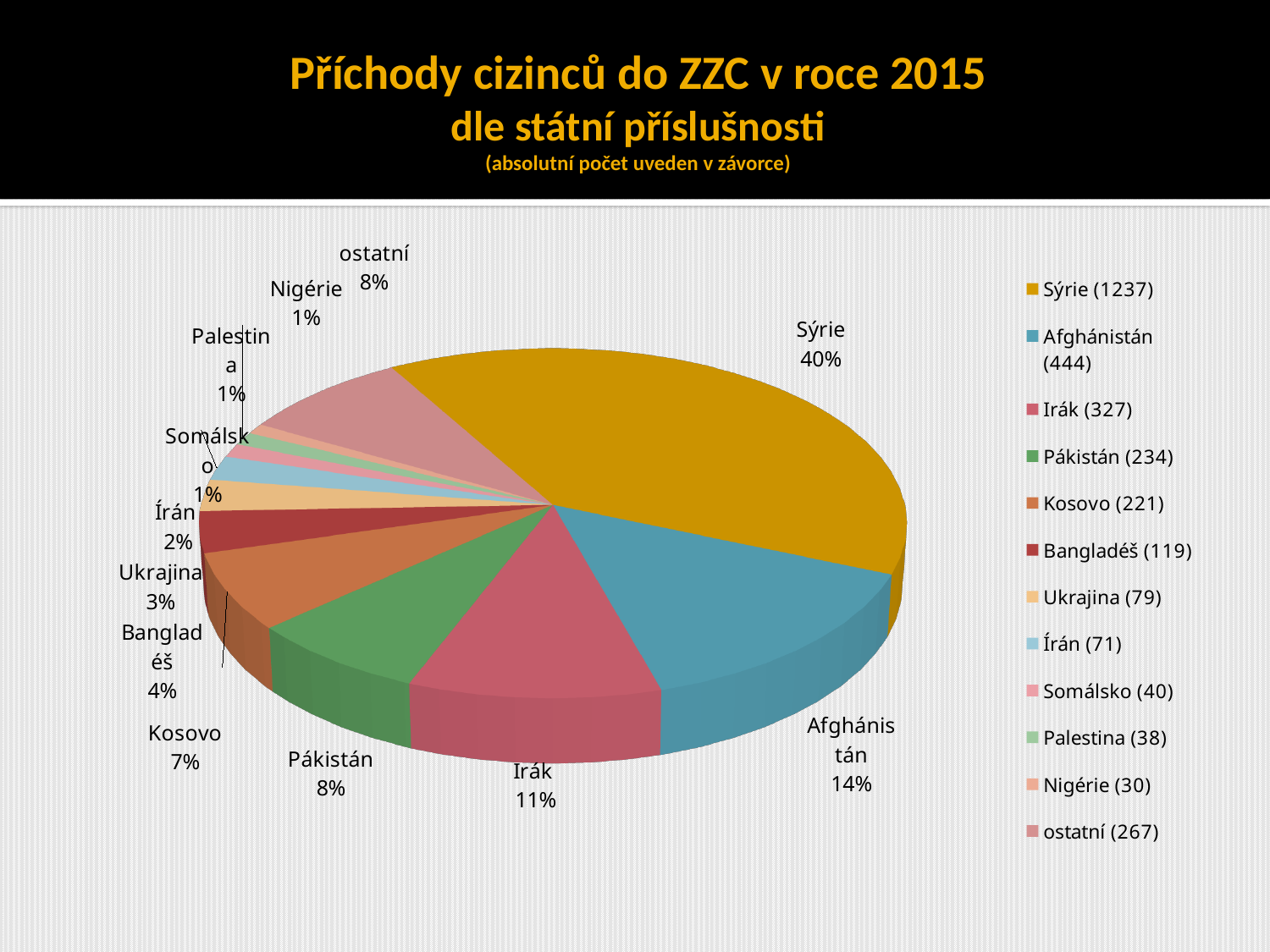
What kind of chart is shown on the slide? pie chart How many slices does the pie chart have? 12 What is the difference between the absolute counts for Pákistán and Kosovo? 13 According to the absolute counts in the legend, which country has the smallest number? Nigérie (30) Which country has the largest slice of the pie? Sýrie What absolute number is given for Irák in the legend? 327 What percentage is shown for Afghánistán? 14% What is the difference in percentage points between Sýrie and Afghánistán? 26 percentage points What is the main title of the chart on the slide? Příchody cizinců do ZZC v roce 2015 What percentage is shown for the 'ostatní' slice? 8% Which has a larger share, Irák or Kosovo? Irák What share of the pie does Sýrie represent? 40%